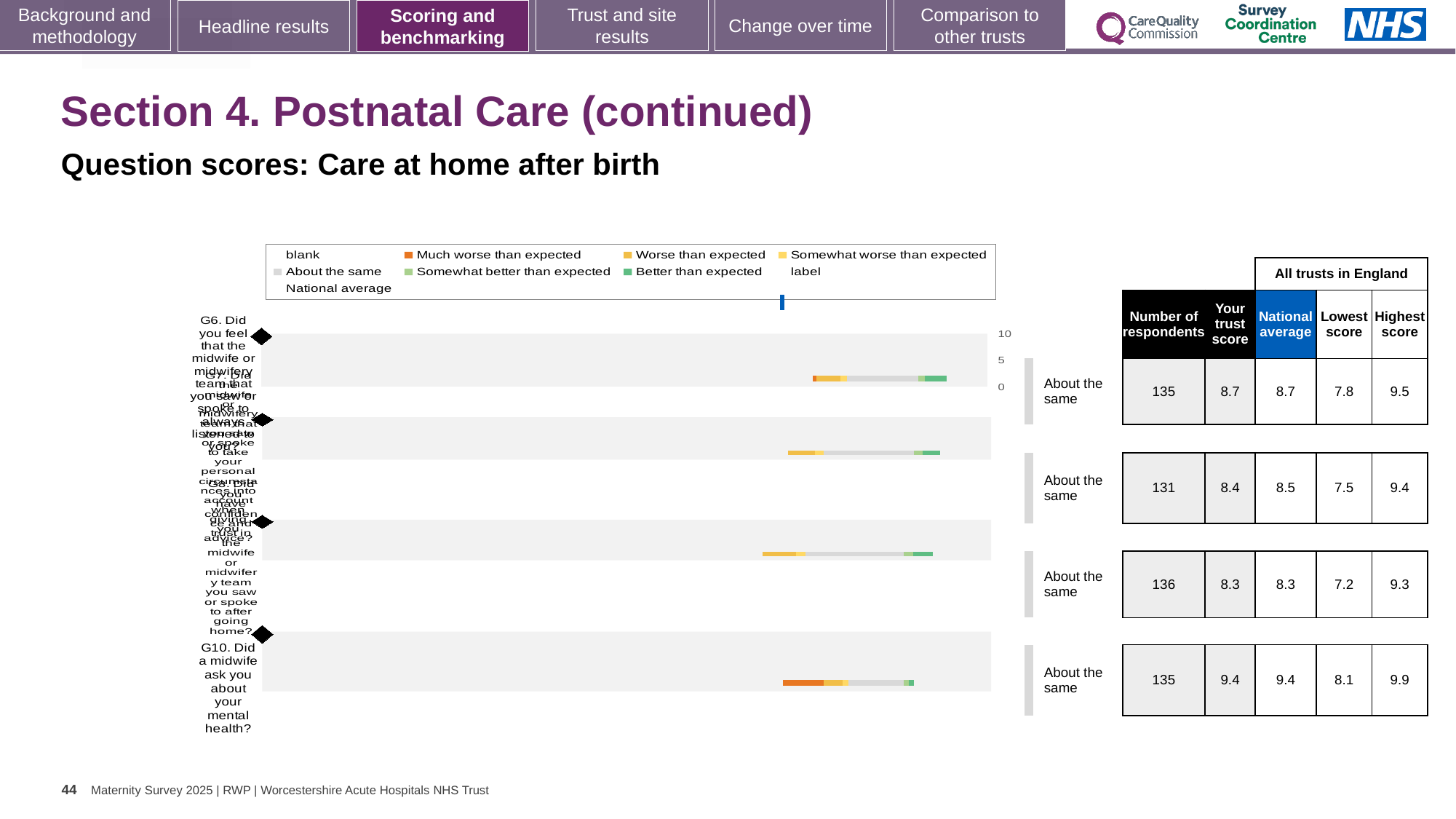
For 'G10. Did a midwife ask you about your mental health?', what is the difference between the highest score and the lowest score? 1.8 Which colour in the legend represents 'Better than expected'? green What kind of chart is shown on the slide? bar chart What is the highest score among all trusts in England for 'G10. Did a midwife ask you about your mental health?' 9.9 How many question bars are plotted in the chart? 4 Which colour in the legend represents 'Much worse than expected'? orange What is the number of respondents for 'G10. Did a midwife ask you about your mental health?' 135 What is the national average for 'G10. Did a midwife ask you about your mental health?' 9.4 What benchmark category is shown for every question in the chart? About the same What is the trust score for 'G10. Did a midwife ask you about your mental health?' 9.4 For 'G10. Did a midwife ask you about your mental health?', which is larger: the trust score or the lowest score? the trust score Which question has the highest trust score? G10. Did a midwife ask you about your mental health?